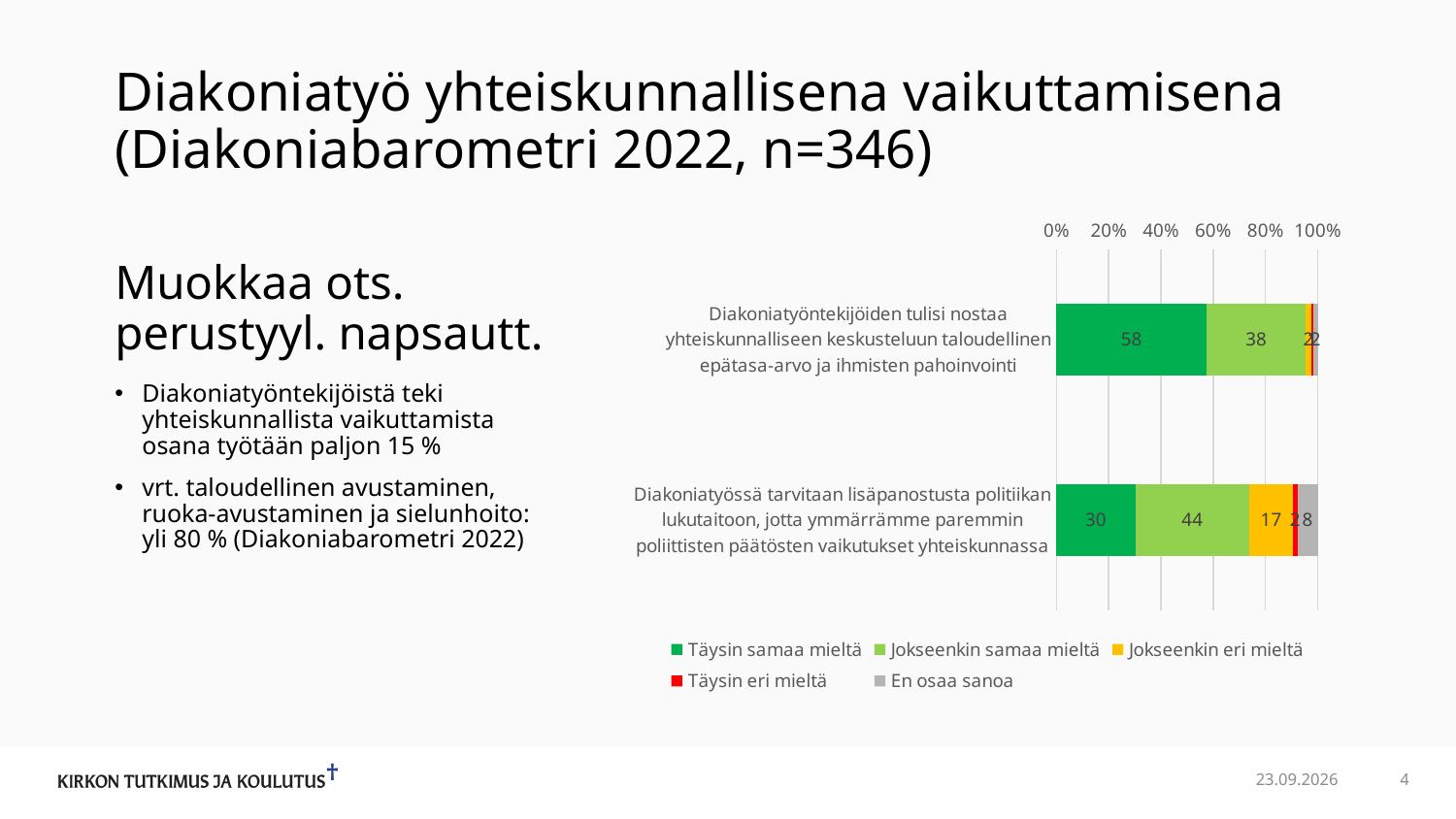
Which bar has the higher 'Täysin samaa mieltä' value, the top bar or the bottom bar? the top bar What is the value of 'Täysin samaa mieltä' for the bottom bar (Diakoniatyössä tarvitaan lisäpanostusta politiikan lukutaitoon...)? 30 What is the difference between the 'Jokseenkin samaa mieltä' values of the bottom bar (44) and the top bar (38)? 6 What is the value of 'Jokseenkin eri mieltä' for the bottom bar (Diakoniatyössä tarvitaan lisäpanostusta politiikan lukutaitoon...)? 17 What is the value of 'Jokseenkin samaa mieltä' for the bottom bar (Diakoniatyössä tarvitaan lisäpanostusta politiikan lukutaitoon...)? 44 How many categories (bars) are plotted in the chart? 2 What is the value of 'Täysin samaa mieltä' for the top bar (Diakoniatyöntekijöiden tulisi nostaa yhteiskunnalliseen keskusteluun...)? 58 What is the difference between the 'Täysin samaa mieltä' values of the top bar (58) and the bottom bar (30)? 28 What kind of chart is shown on the slide? stacked bar chart What is the value of 'Jokseenkin samaa mieltä' for the top bar (Diakoniatyöntekijöiden tulisi nostaa yhteiskunnalliseen keskusteluun...)? 38 Which legend entry is shown in red? Täysin eri mieltä How many series does the legend list? 5